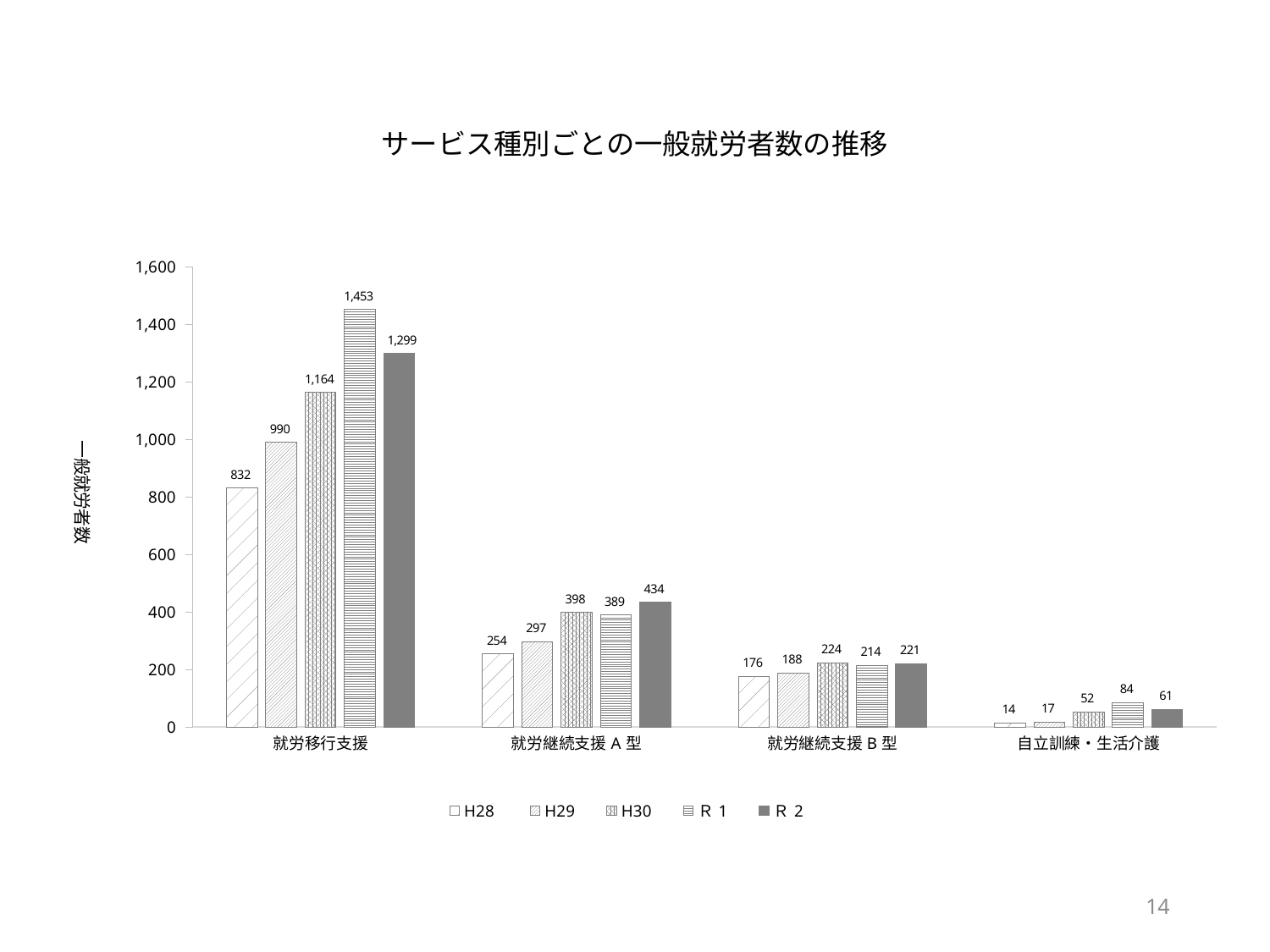
Which is larger for 就労継続支援Ｂ型: the H30 value or the R 1 value? H30 Which category has the highest value in R 2? 就労移行支援 What is the difference between the R 1 and R 2 values for 就労移行支援? 154 What is the title of the chart? サービス種別ごとの一般就労者数の推移 What is the value for 自立訓練・生活介護 in R 2? 61 Is the R 2 value for 就労継続支援Ａ型 greater or less than 400? greater How many categories are shown on the x axis? 4 What is the value for 就労移行支援 in R 1? 1,453 What is the value for 就労継続支援Ａ型 in H28? 254 How many series does the legend list? 5 Which category has the lowest value in H28? 自立訓練・生活介護 What kind of chart is shown on the slide? bar chart